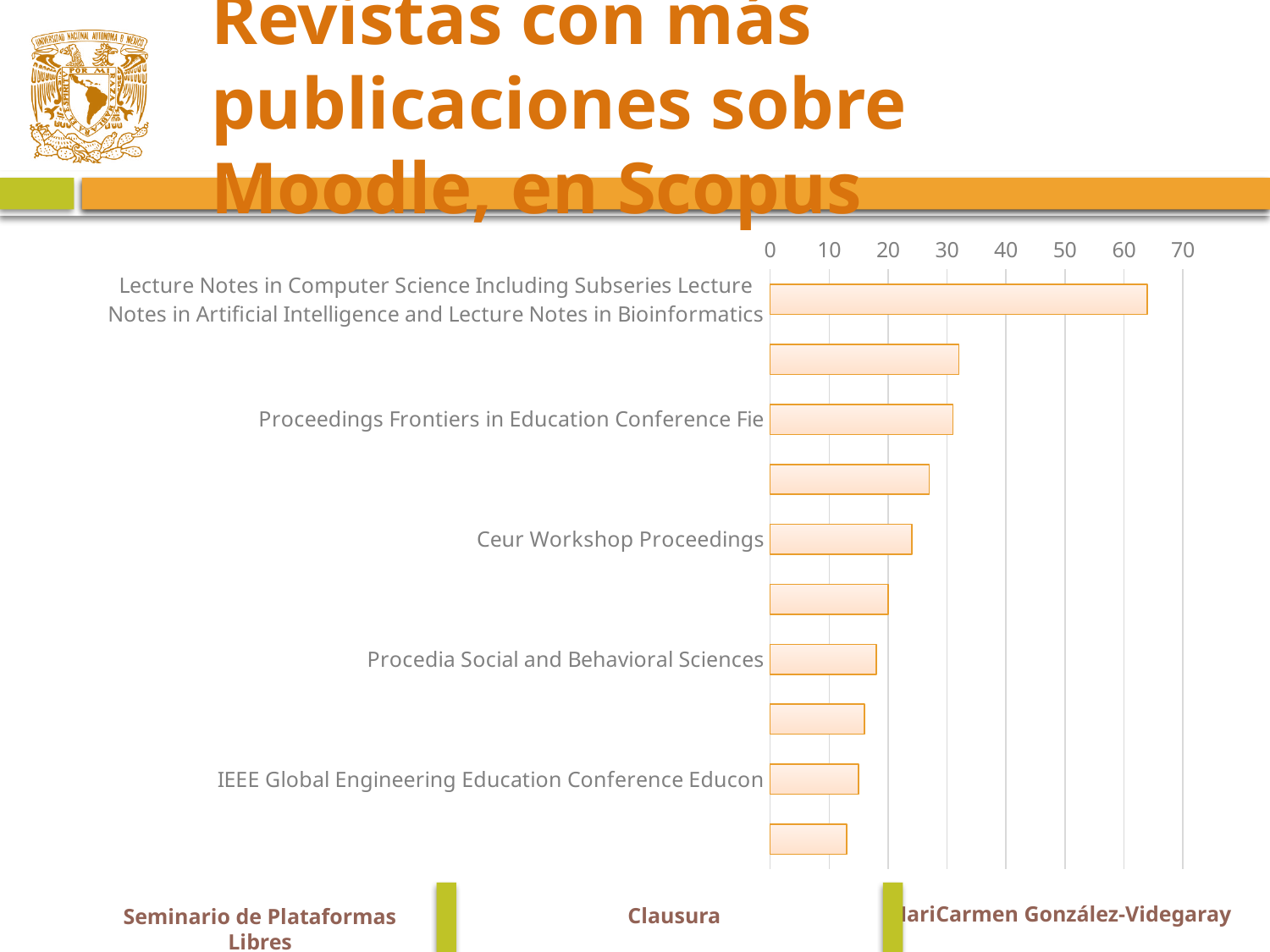
Which is larger, the value for Proceedings Frontiers in Education Conference Fie or the value for IEEE Global Engineering Education Conference Educon? Proceedings Frontiers in Education Conference Fie Is the value for Ceur Workshop Proceedings greater or less than 30? less Is the value for Lecture Notes in Computer Science greater or less than 60? greater How many bars are plotted in the chart? 10 Which category has the highest value in the chart? Lecture Notes in Computer Science Including Subseries Lecture Notes in Artificial Intelligence and Lecture Notes in Bioinformatics Which is larger, the value for Ceur Workshop Proceedings or the value for Procedia Social and Behavioral Sciences? Ceur Workshop Proceedings Do the bar values increase or decrease going from the top of the chart to the bottom? Decrease What kind of chart is shown on the slide? Bar chart What is the highest value shown on the chart's value axis? 70 Is the value for Proceedings Frontiers in Education Conference Fie greater or less than 40? less